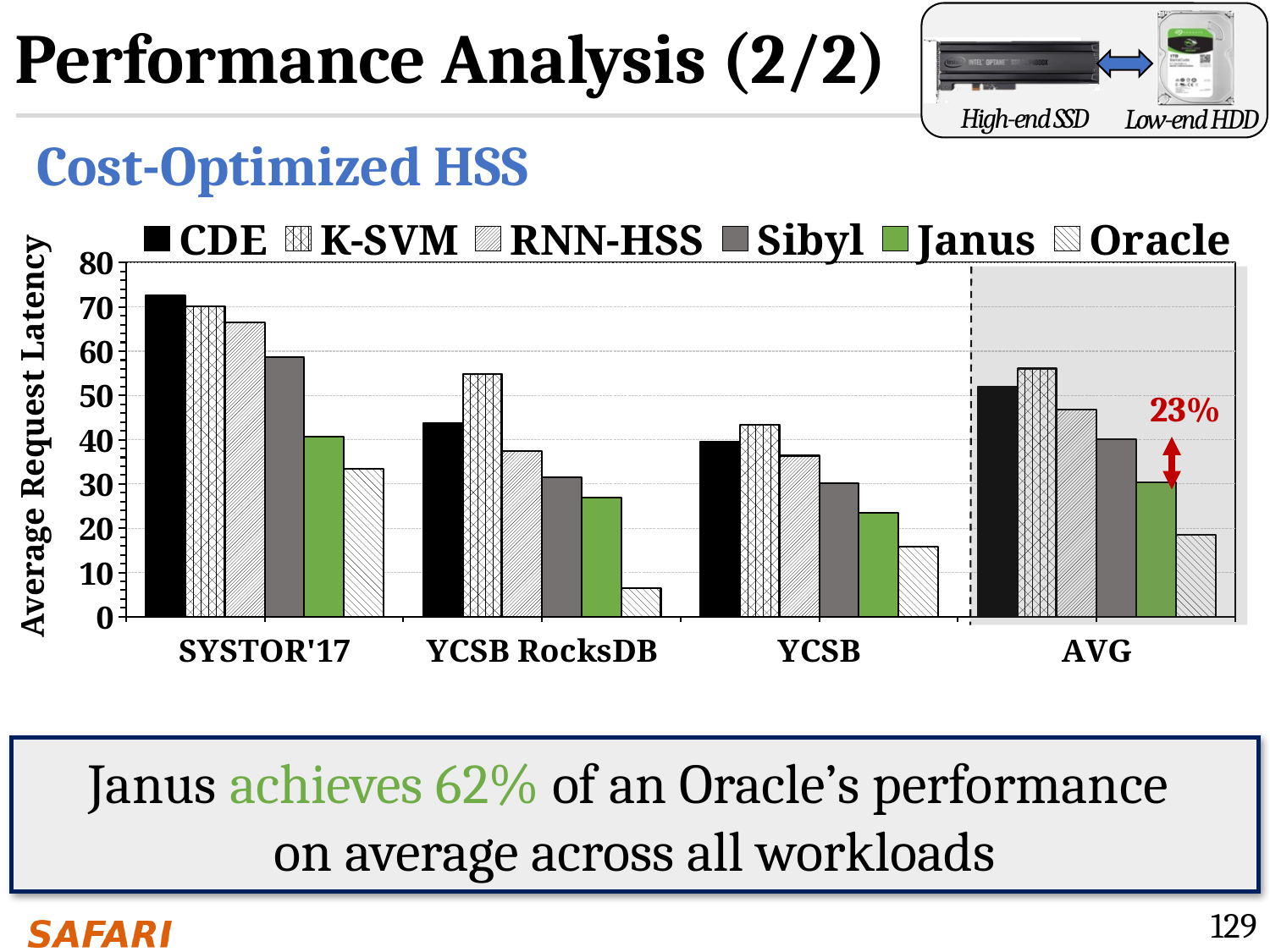
What kind of chart is shown on the slide? bar chart What percentage is annotated between the Janus and Oracle bars in the AVG group? 23% For YCSB, which is larger: the value for Sibyl or the value for Janus? Sibyl How many workload categories are shown on the x axis? 4 Is the value for K-SVM on YCSB RocksDB greater or less than 50? greater Is the value for CDE on SYSTOR'17 greater or less than 70? greater Which series has the highest average request latency for YCSB RocksDB? K-SVM What is the label of the y axis? Average Request Latency How many series does the legend list? 6 Which series has the highest average request latency for SYSTOR'17? CDE Is the value for Oracle on YCSB RocksDB greater or less than 10? less Which series has the lowest average request latency for YCSB? Oracle